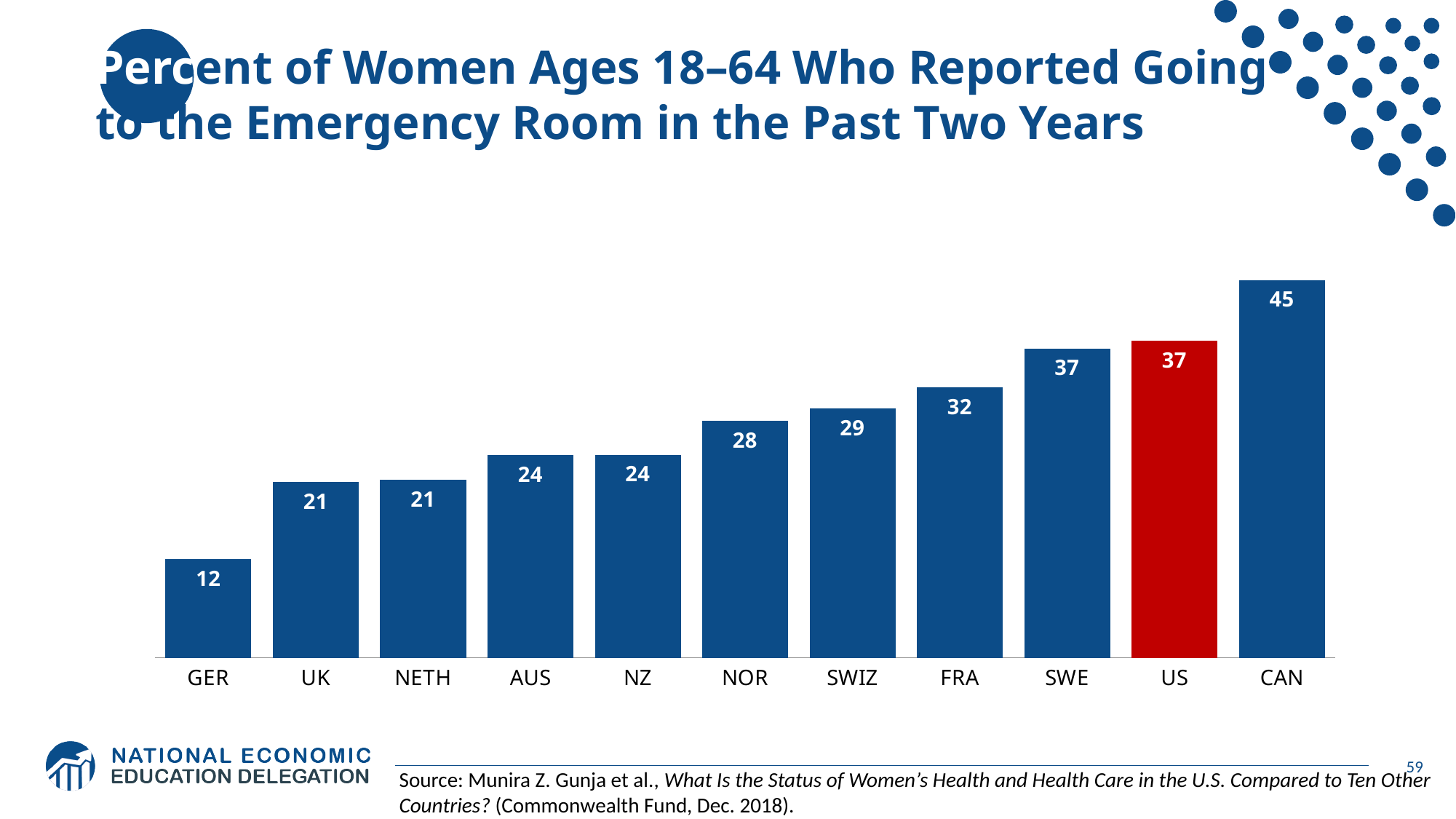
What is the value for GER? 12 Do the values rise or fall from left to right along the x axis? rise What kind of chart is shown on the slide? bar chart What is the difference between the values for FRA and GER? 20 What is the difference between the values for CAN and the US? 8 Which country has the highest value? CAN What is the value for the US? 37 Which country's bar is coloured red? US What is the value for NOR? 28 How many countries are shown on the chart? 11 Which is larger, the value for SWIZ or the value for AUS? SWIZ Which country has the lowest value? GER